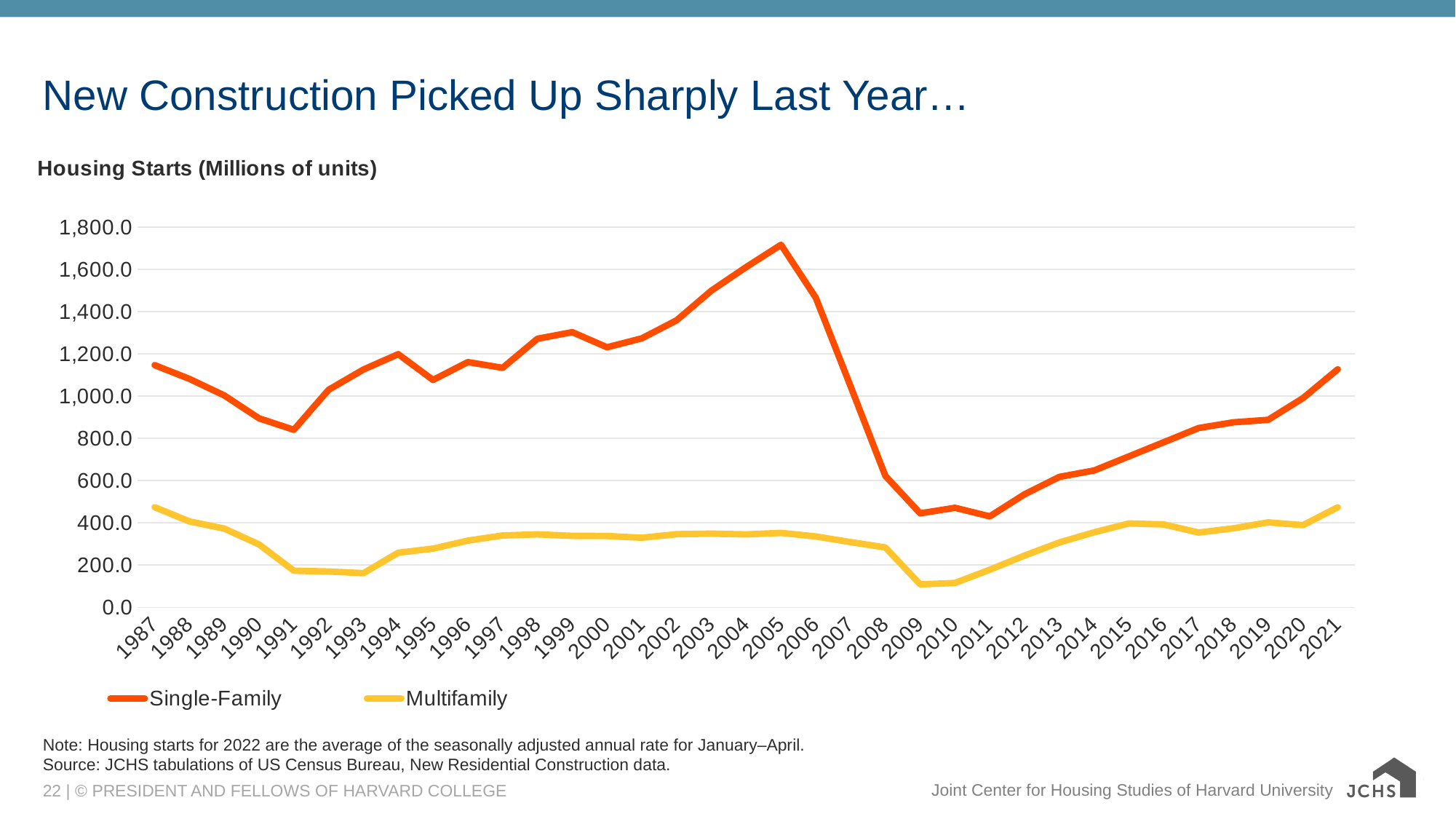
Is the Single-Family value for 2009 greater or less than 600.0? less In which year does the Single-Family series reach its highest value? 2005 Is the Multifamily value for 2009 greater or less than 200.0? less In which year does the Multifamily series reach its lowest value? 2009 How many series does the legend list? 2 What kind of chart is shown on the slide? line chart What is the title of the chart's y-axis measure shown above the plot? Housing Starts (Millions of units) Which series has the larger value in 2021, Single-Family or Multifamily? Single-Family In which year does the Single-Family series reach its lowest value? 2011 Does the Single-Family series rise or fall from 2011 to 2021? rise Is the Single-Family value for 2005 greater or less than 1,600.0? greater How many years are plotted along the x axis? 35